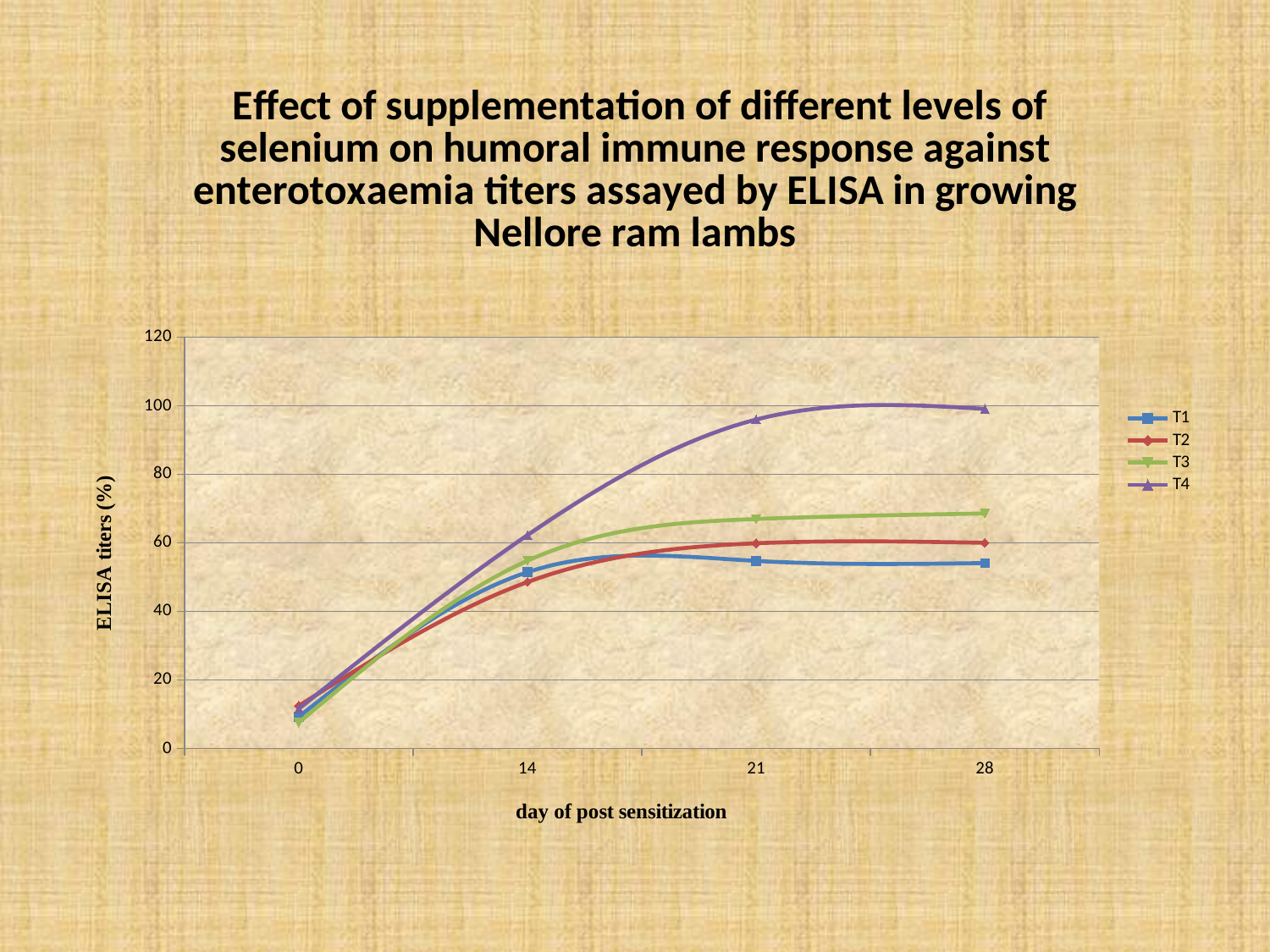
At day 21, which series has the larger value, T4 or T3? T4 Is the value for T1 at day 28 greater or less than 60? less Is the value for T3 at day 28 greater or less than 60? greater What is the title of the y axis? ELISA titers (%) How many series does the legend list? 4 Which series has the highest ELISA titer at day 28? T4 Which series has the lowest ELISA titer at day 28? T1 Is the value for T2 at day 14 greater or less than 60? less How many days of post sensitization are plotted along the x axis? 4 Does the T4 series rise or fall from day 0 to day 28? rise What kind of chart is shown on the slide? line chart